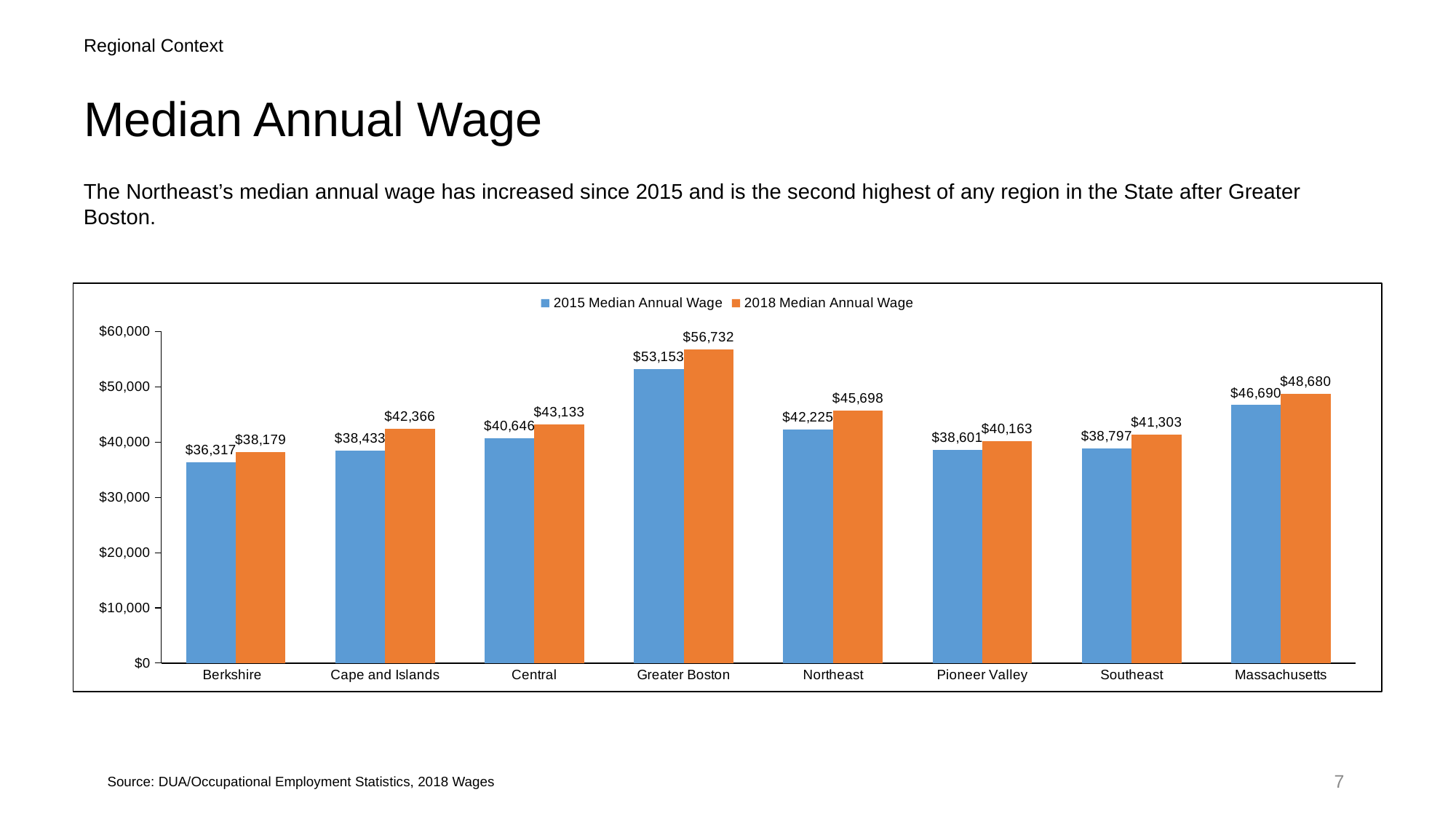
Which region has the highest 2018 Median Annual Wage? Greater Boston What type of chart is shown on the slide? Bar chart Is the 2015 Median Annual Wage for Central greater or less than $40,000? greater Which region has the lowest 2015 Median Annual Wage? Berkshire What is the difference between the 2018 and 2015 Median Annual Wage for Greater Boston? $3,579 Which is larger: the 2018 Median Annual Wage for Pioneer Valley or for Southeast? Southeast What is the 2015 Median Annual Wage for the Northeast? $42,225 What is the 2018 Median Annual Wage for Cape and Islands? $42,366 How many series does the chart's legend list? 2 What is the 2018 Median Annual Wage for Massachusetts? $48,680 By how much did the Northeast's median annual wage increase from 2015 to 2018? $3,473 How many regions are shown on the x axis of the chart? 8